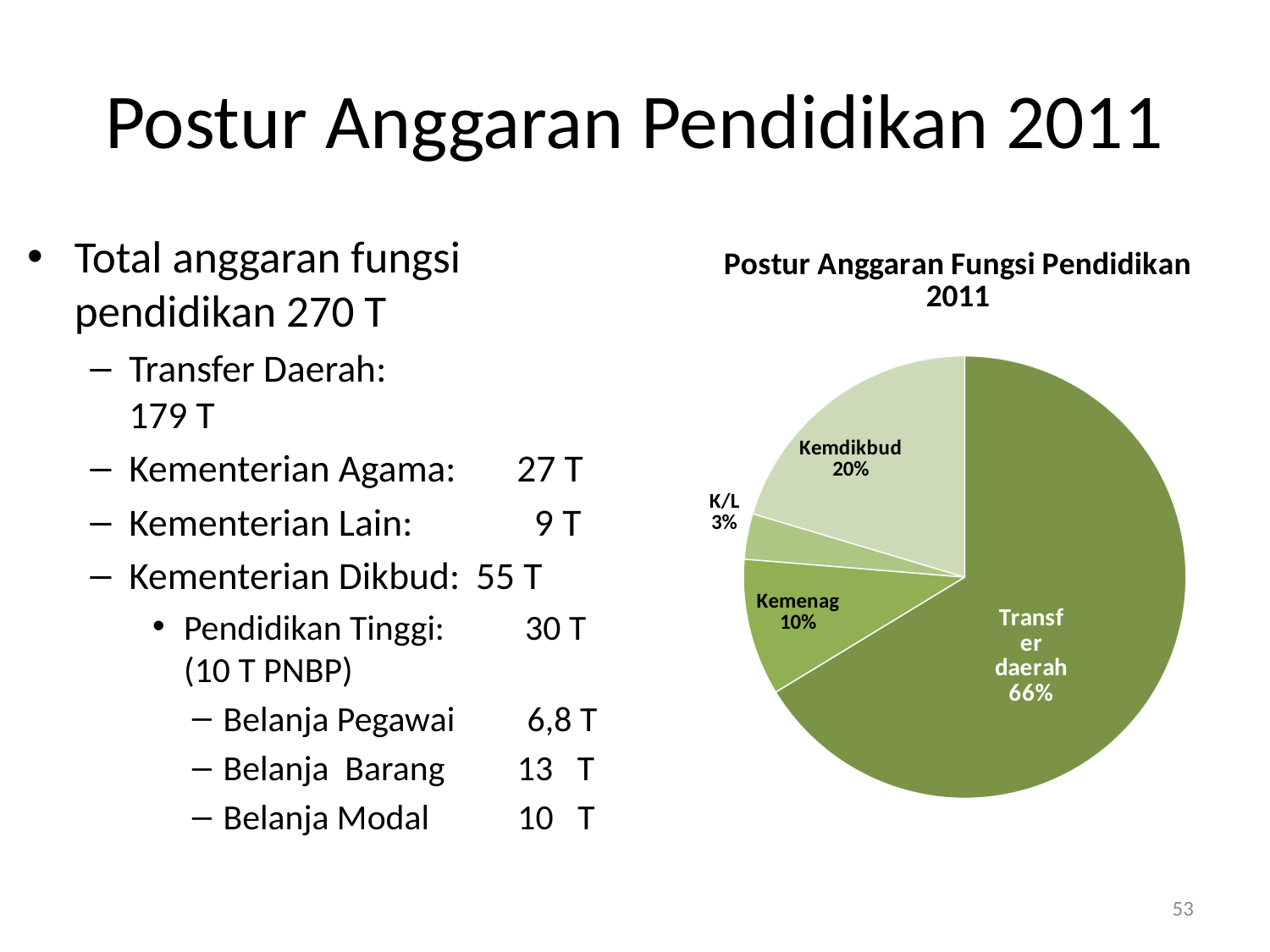
How many slices does the pie chart have? 4 Which is larger, the Kemenag slice or the Kemdikbud slice? Kemdikbud What share of the pie does K/L represent? 3% Which slice of the pie is the smallest? K/L What is the title of the chart? Postur Anggaran Fungsi Pendidikan 2011 What is the difference in percentage points between the Transfer daerah and Kemdikbud slices? 46 What share of the pie does Kemenag represent? 10% Which slice of the pie is the largest? Transfer daerah What is the difference in percentage points between the Kemdikbud and Kemenag slices? 10 What share of the pie does Transfer daerah represent? 66% What type of chart is shown on the slide? pie chart